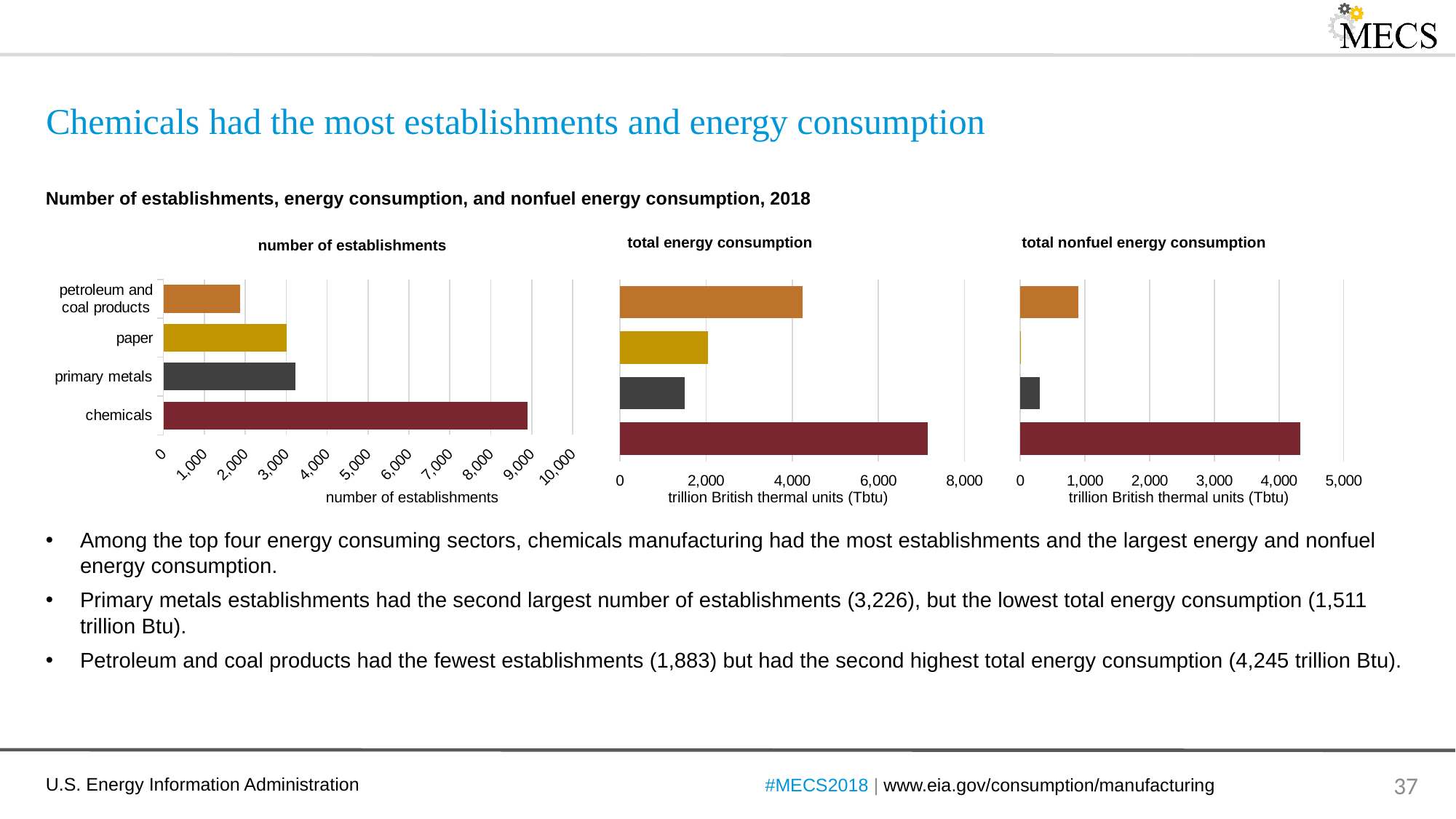
What unit is shown on the x axis of the "total energy consumption" chart? trillion British thermal units (Tbtu) What kind of chart is the "number of establishments" chart? bar chart In the "number of establishments" chart, is the value for chemicals greater or less than 8,000? greater In the "total energy consumption" chart, which sector has the highest value? chemicals In the "number of establishments" chart, which sector has the lowest value? petroleum and coal products In the "total nonfuel energy consumption" chart, which sector has the lowest value? paper How many sectors are shown in the "number of establishments" chart? 4 In the "number of establishments" chart, which sector has the highest value? chemicals In the "total energy consumption" chart, which is larger: petroleum and coal products or paper? petroleum and coal products According to the slide, how many establishments did primary metals have? 3,226 In the "total energy consumption" chart, is the value for petroleum and coal products greater or less than 4,000? greater In the "total energy consumption" chart, which sector has the lowest value? primary metals